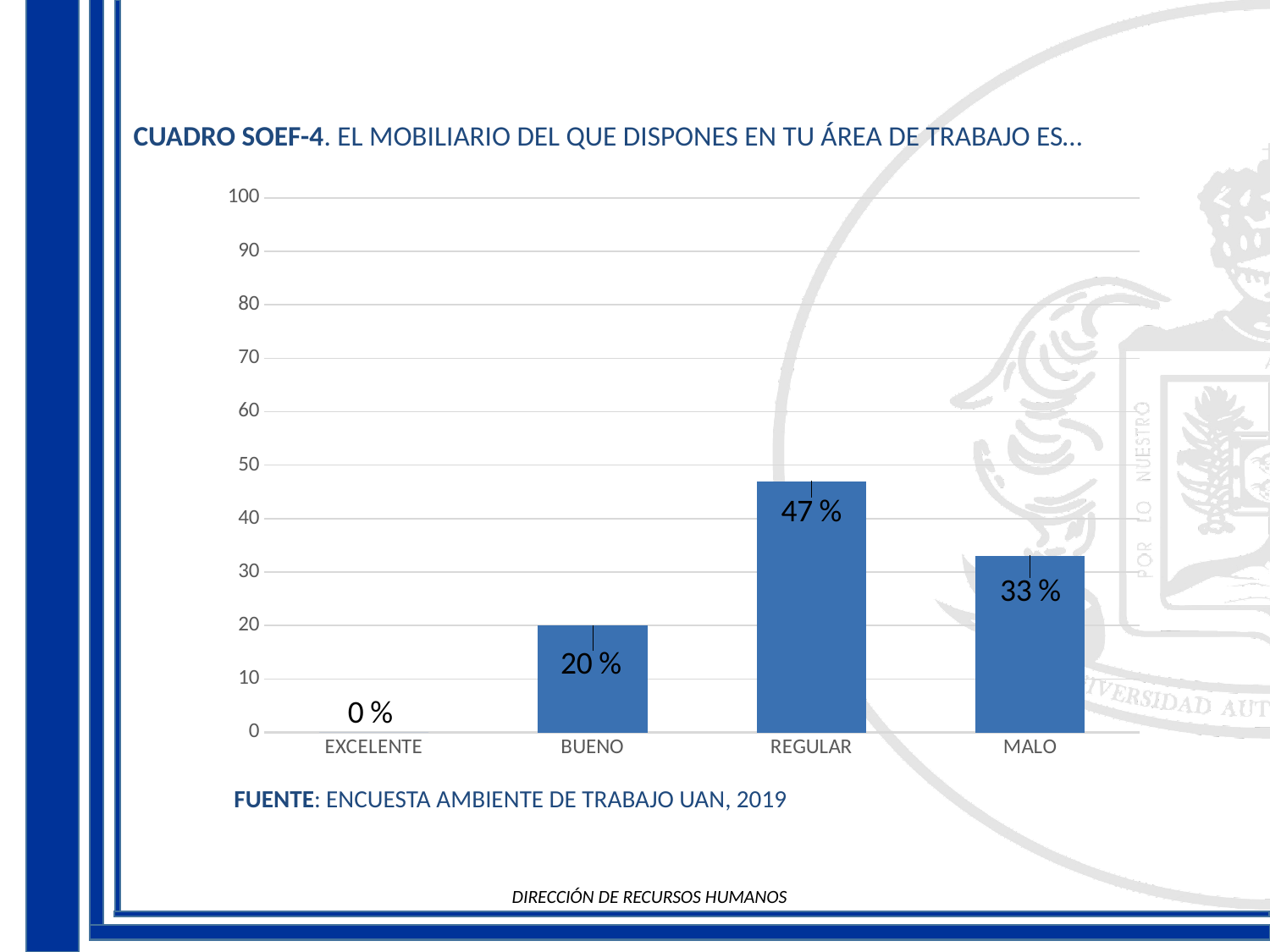
Is the value for REGULAR greater or less than 50? less What kind of chart is shown on the slide? bar chart What is the value for EXCELENTE? 0 % How many categories are shown on the x axis? 4 What is the value for REGULAR? 47 % What source is cited below the chart? ENCUESTA AMBIENTE DE TRABAJO UAN, 2019 Which is larger, the value for BUENO or the value for MALO? MALO What is the difference between the values for REGULAR and MALO? 14 % Which category has the highest value? REGULAR What is the value for BUENO? 20 % Which category has the lowest value? EXCELENTE What is the value for MALO? 33 %